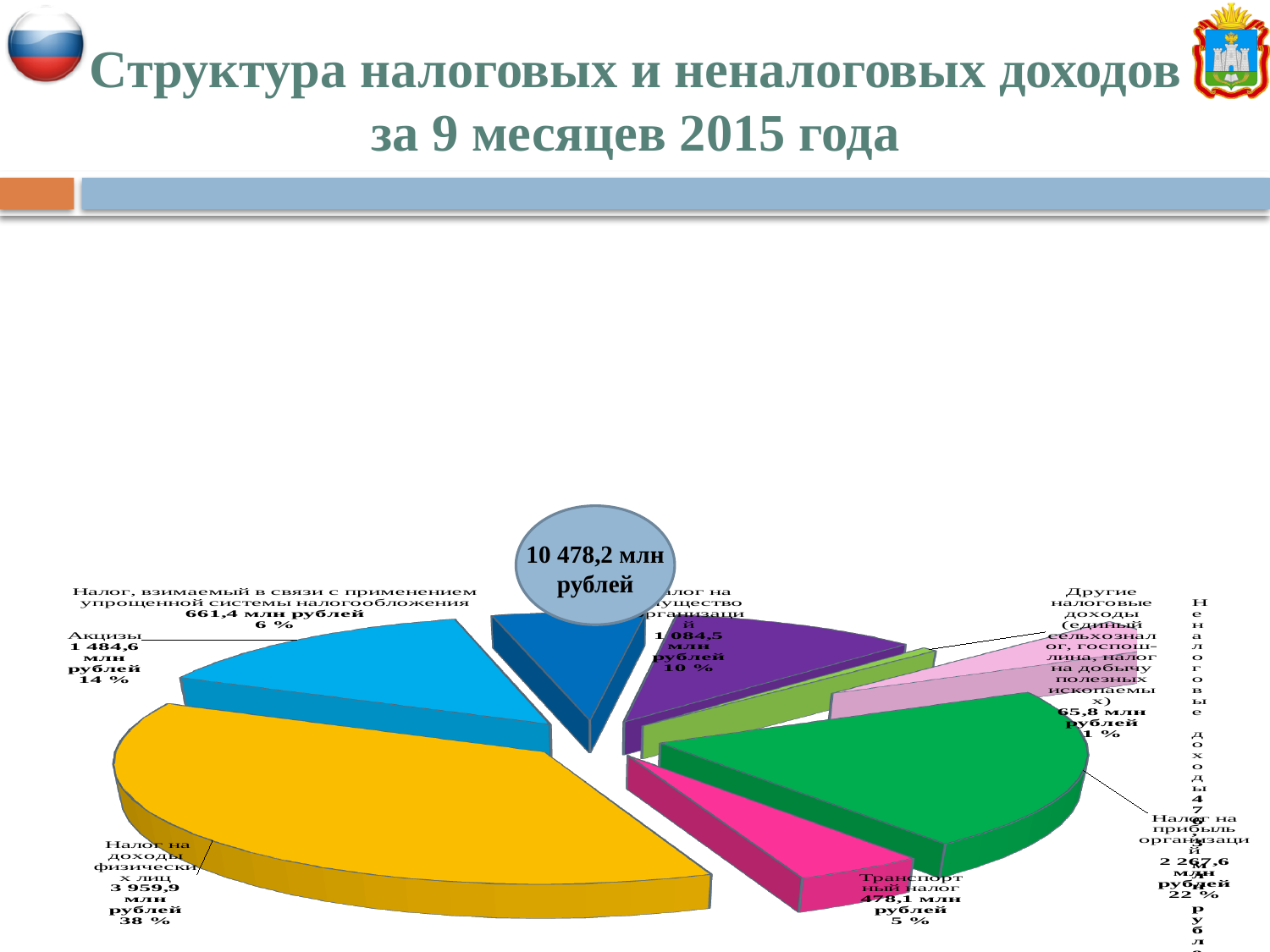
What total amount is shown in the circle at the centre of the chart? 10 478,2 млн рублей What is the difference in percentage points between the shares of "Налог на доходы физических лиц" (38 %) and "Налог на прибыль организаций" (22 %)? 16 What is the value shown for "Транспортный налог"? 478,1 млн рублей What is the value shown for the tax under the simplified taxation system ("Налог, взимаемый в связи с применением упрощенной системы налогообложения")? 661,4 млн рублей What is the value shown for "Акцизы"? 1 484,6 млн рублей Which category has the largest slice of the pie? Налог на доходы физических лиц What is the title of the slide? Структура налоговых и неналоговых доходов за 9 месяцев 2015 года What share of the pie does "Налог на доходы физических лиц" account for? 38 % What share of the pie does "Налог на имущество организаций" account for? 10 % Which is larger, "Акцизы" or "Налог на имущество организаций"? Акцизы What is the value shown for "Налог на прибыль организаций"? 2 267,6 млн рублей What kind of chart is shown on the slide? pie chart